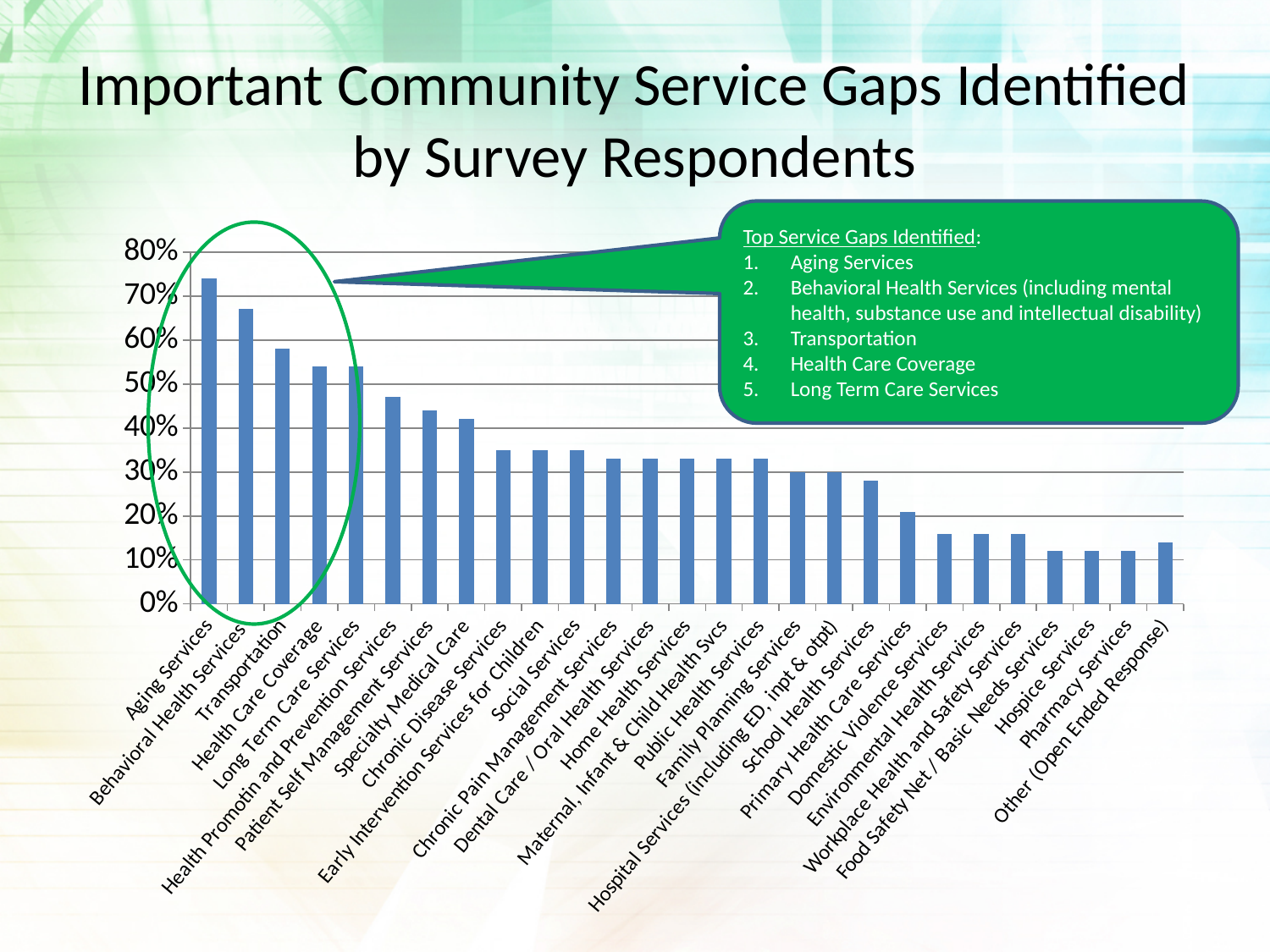
Which category has the highest value in the chart? Aging Services Is the value for Primary Health Care Services greater or less than 30%? less How many categories are plotted along the x axis of the chart? 27 Is the value for Hospice Services greater or less than 20%? less Which is larger, the value for Transportation or the value for Social Services? Transportation Is the value for Transportation greater or less than 50%? greater Which is larger, the value for Aging Services or the value for Behavioral Health Services? Aging Services What kind of chart is shown on the slide? Bar chart Do the bar values generally rise or fall from left to right along the x axis? Fall According to the callout box, which service gap is listed third among the top service gaps identified? Transportation